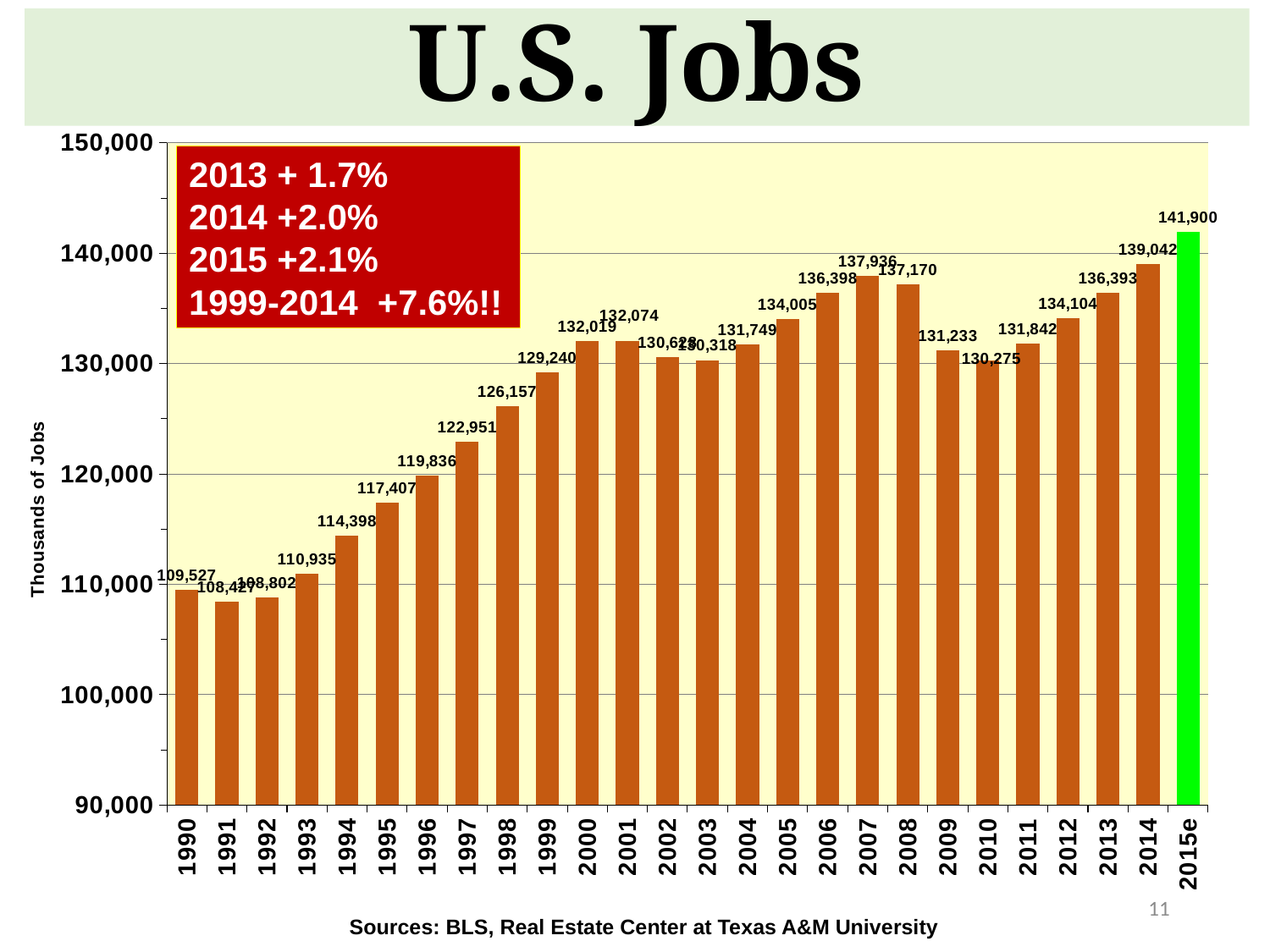
What is the value for 2000? 132,019 What is the difference between the values for 2014 and 2013? 2,649 What is the value for 2014? 139,042 What kind of chart is this? bar chart Is the value for 1996 greater or less than 120,000? less How many bars are shown on the chart? 26 Which year has the highest value? 2015e Which is larger, the value for 2007 or the value for 2008? 2007 What colour is the bar for 2015e? green What is the value for 2015e? 141,900 What is the difference between the values for 2007 and 2009? 6,703 What is the value for 2007? 137,936